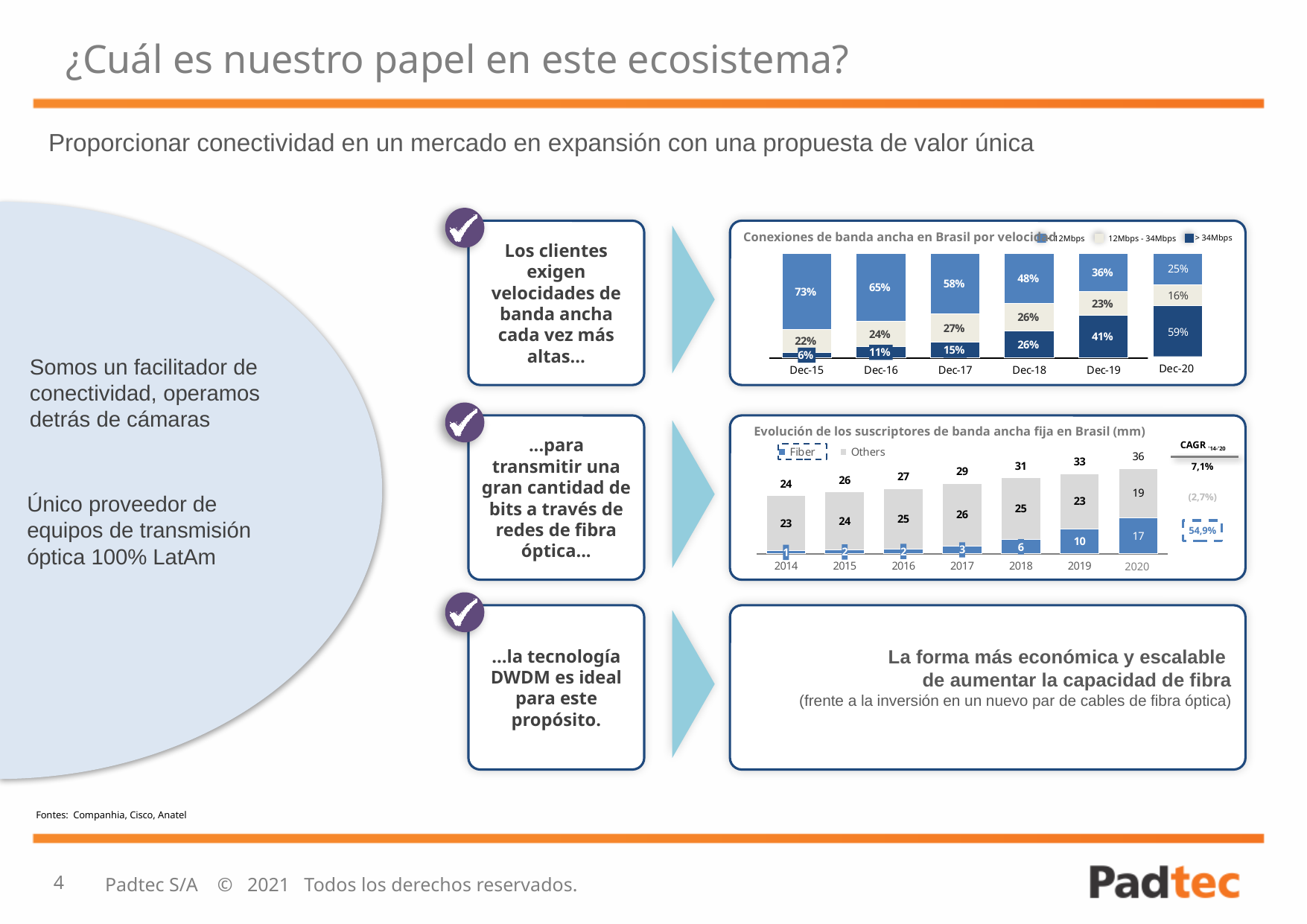
In the chart 'Evolución de los suscriptores de banda ancha fija en Brasil (mm)', what is the difference between the Fiber values for 2020 and 2018? 11 In the chart 'Evolución de los suscriptores de banda ancha fija en Brasil (mm)', which year has the highest Others value? 2017 In the chart 'Evolución de los suscriptores de banda ancha fija en Brasil (mm)', how many series does the legend list? 2 What type of chart is 'Evolución de los suscriptores de banda ancha fija en Brasil (mm)'? Stacked bar chart In the chart 'Conexiones de banda ancha en Brasil por velocidad', what is the value of the > 34Mbps segment for Dec-20? 59% In the chart 'Conexiones de banda ancha en Brasil por velocidad', what is the value of the 12Mbps - 34Mbps segment for Dec-17? 27% In the chart 'Conexiones de banda ancha en Brasil por velocidad', how many periods are shown on the x axis? 6 In the chart 'Evolución de los suscriptores de banda ancha fija en Brasil (mm)', what is the Fiber value for 2019? 10 In the chart 'Evolución de los suscriptores de banda ancha fija en Brasil (mm)', what is the total for 2020? 36 In the chart 'Conexiones de banda ancha en Brasil por velocidad', how does the > 34Mbps share change from Dec-15 to Dec-20? It rises In the chart 'Evolución de los suscriptores de banda ancha fija en Brasil (mm)', is the Fiber value larger in 2019 or in 2020? 2020 In the chart 'Conexiones de banda ancha en Brasil por velocidad', which period has the lowest > 34Mbps share? Dec-15